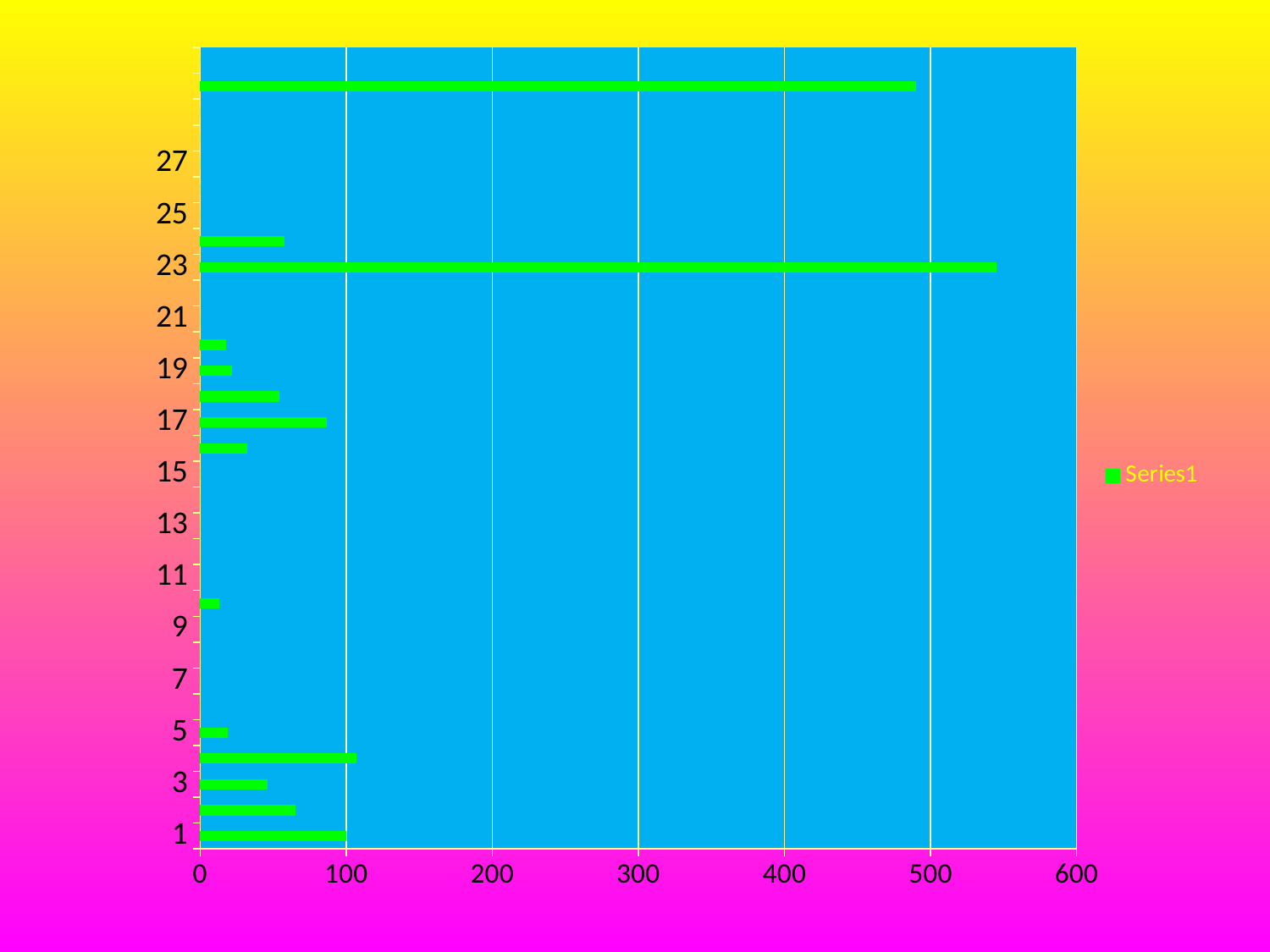
Which labelled category has the longest bar? 23 Which has the larger value, category 1 or category 3? 1 Which has the larger value, category 23 or category 17? 23 What kind of chart is shown on the slide? bar chart Is the value for category 3 greater or less than 100? less Is the value for category 5 greater or less than 100? less How many series does the legend list? 1 Which has the larger value, category 17 or category 19? 17 Is the value for category 23 greater or less than 500? greater What is the name of the series shown in the legend? Series1 What is the highest value shown on the horizontal axis? 600